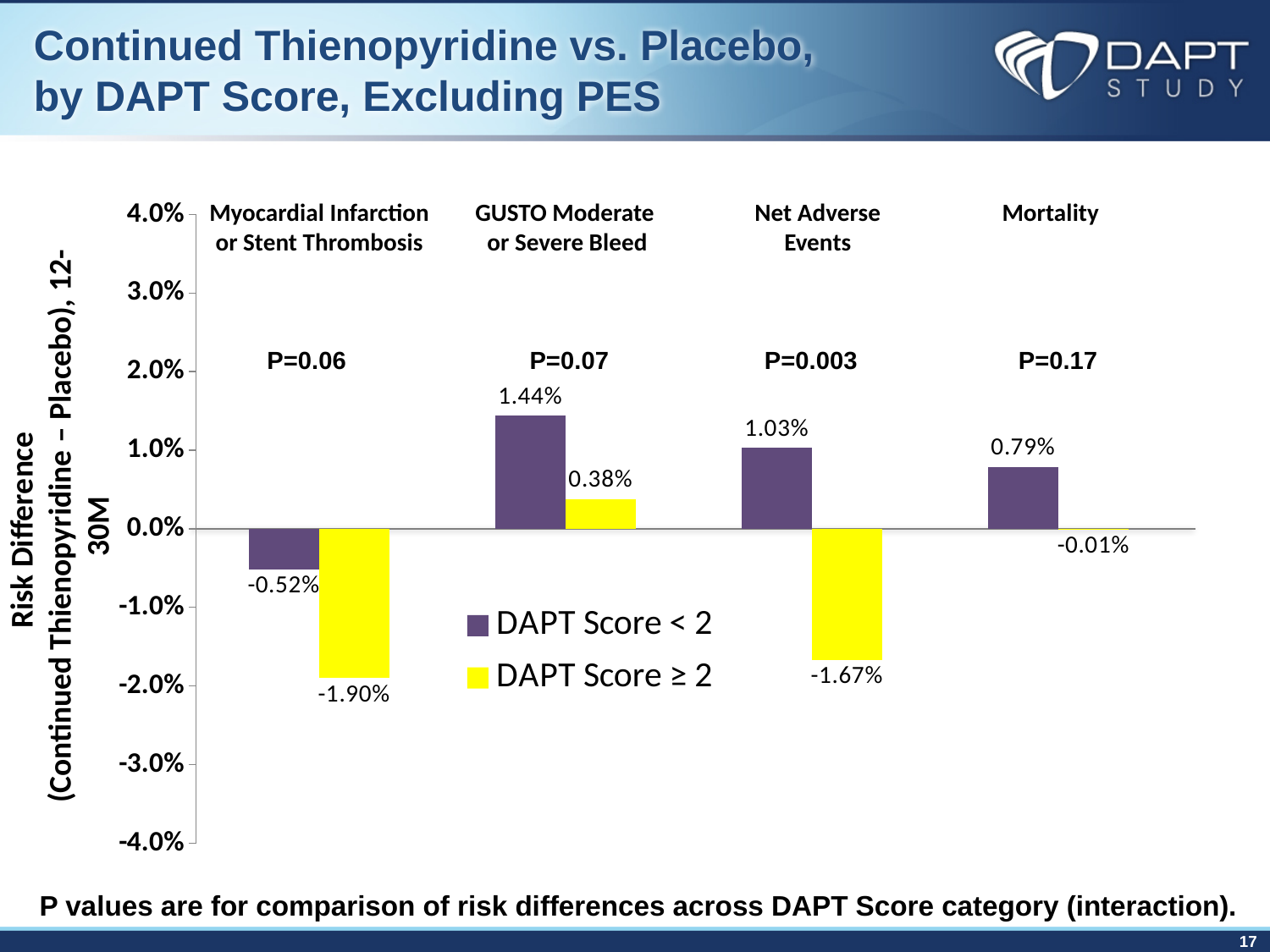
What kind of chart is shown on the slide? Bar chart What is the risk difference for Myocardial Infarction or Stent Thrombosis in the DAPT Score < 2 group? -0.52% What is the risk difference for Net Adverse Events in the DAPT Score ≥ 2 group? -1.67% What is the difference between the DAPT Score < 2 and DAPT Score ≥ 2 risk differences for GUSTO Moderate or Severe Bleed? 1.06% For Net Adverse Events, which group has the larger risk difference: DAPT Score < 2 or DAPT Score ≥ 2? DAPT Score < 2 What P value is shown for Net Adverse Events? P=0.003 What is the risk difference for Mortality in the DAPT Score < 2 group? 0.79% Which outcome has the highest risk difference in the DAPT Score < 2 group? GUSTO Moderate or Severe Bleed What is the risk difference for GUSTO Moderate or Severe Bleed in the DAPT Score ≥ 2 group? 0.38% How many series does the legend list? 2 Which outcome has the lowest risk difference in the DAPT Score ≥ 2 group? Myocardial Infarction or Stent Thrombosis How many outcome categories are shown on the chart? 4